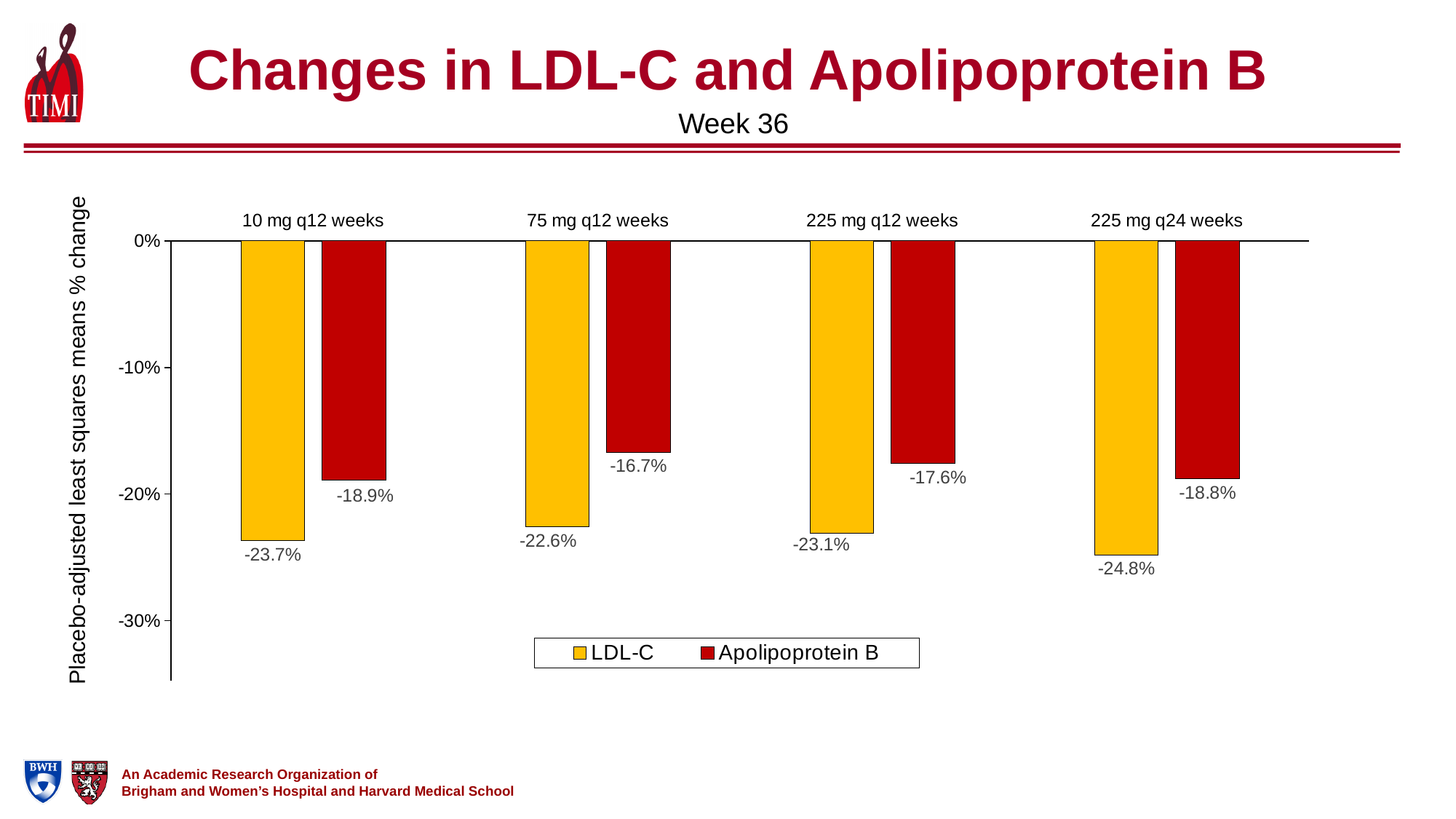
What is the Apolipoprotein B value for 75 mg q12 weeks? -16.7% Which dose group shows the smallest reduction in Apolipoprotein B? 75 mg q12 weeks What is the LDL-C value for 10 mg q12 weeks? -23.7% What is the Apolipoprotein B value for 225 mg q12 weeks? -17.6% What kind of chart is shown on the slide? Bar chart How many dose groups are shown on the x axis? 4 What is the LDL-C value for 225 mg q24 weeks? -24.8% How many series does the legend list? 2 Which has a larger reduction in LDL-C: 75 mg q12 weeks or 225 mg q12 weeks? 225 mg q12 weeks What is the difference between the LDL-C and Apolipoprotein B values for 225 mg q24 weeks? 6.0 percentage points What is the y-axis label of the chart? Placebo-adjusted least squares means % change Which dose group shows the largest reduction in LDL-C? 225 mg q24 weeks